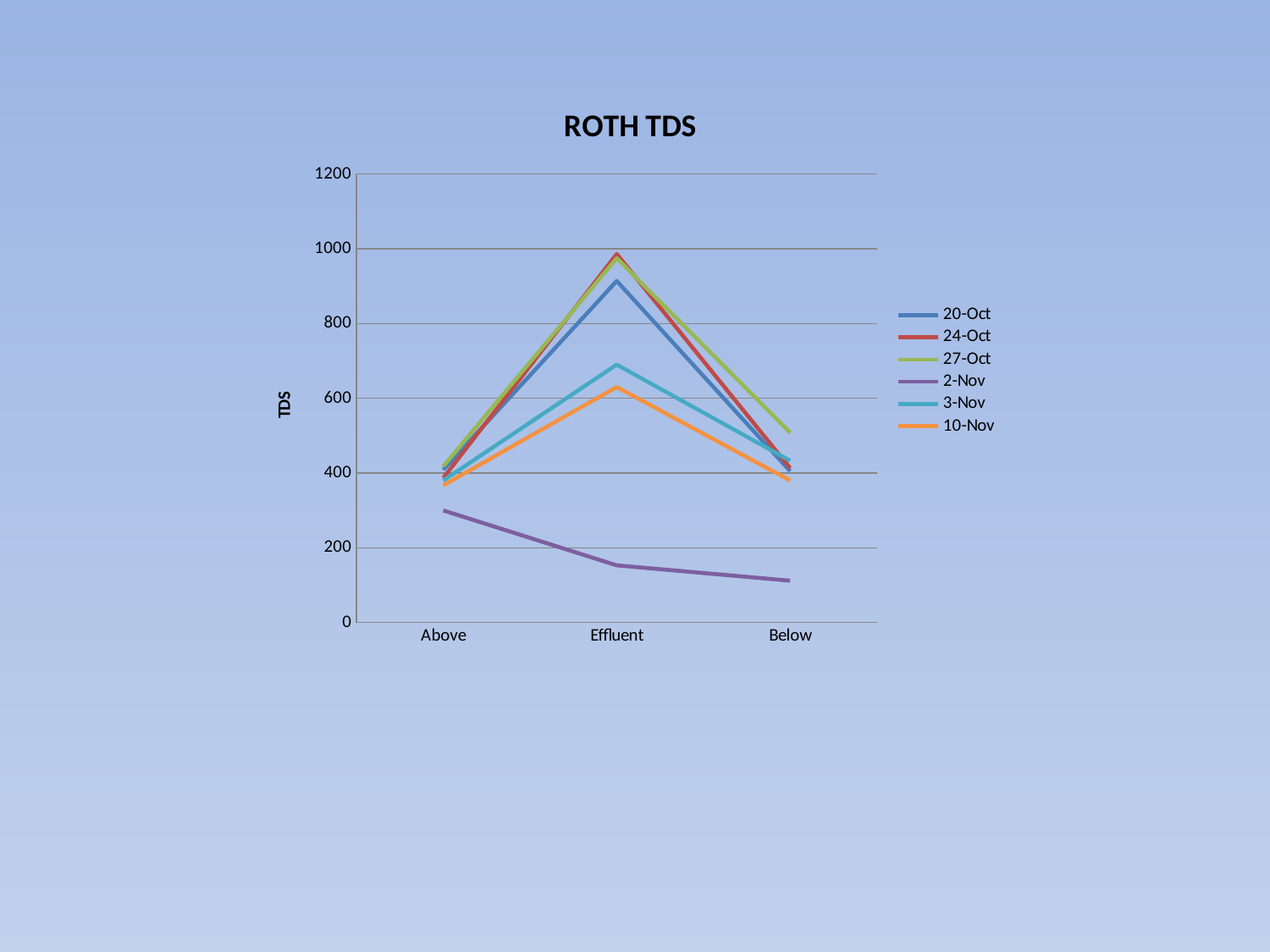
Is the value for 20-Oct at Effluent greater or less than 800? greater Is the value for 10-Nov at Effluent greater or less than 600? greater Which series has the highest value at Below? 27-Oct Is the value for 2-Nov at Effluent greater or less than 200? less How many series does the legend list? 6 Which series has the lowest value at Effluent? 2-Nov What is the title of the chart? ROTH TDS What kind of chart is shown on the slide? line chart How many categories are shown on the x axis? 3 What is the label on the vertical axis? TDS Does the 2-Nov line rise or fall from Above to Below? fall